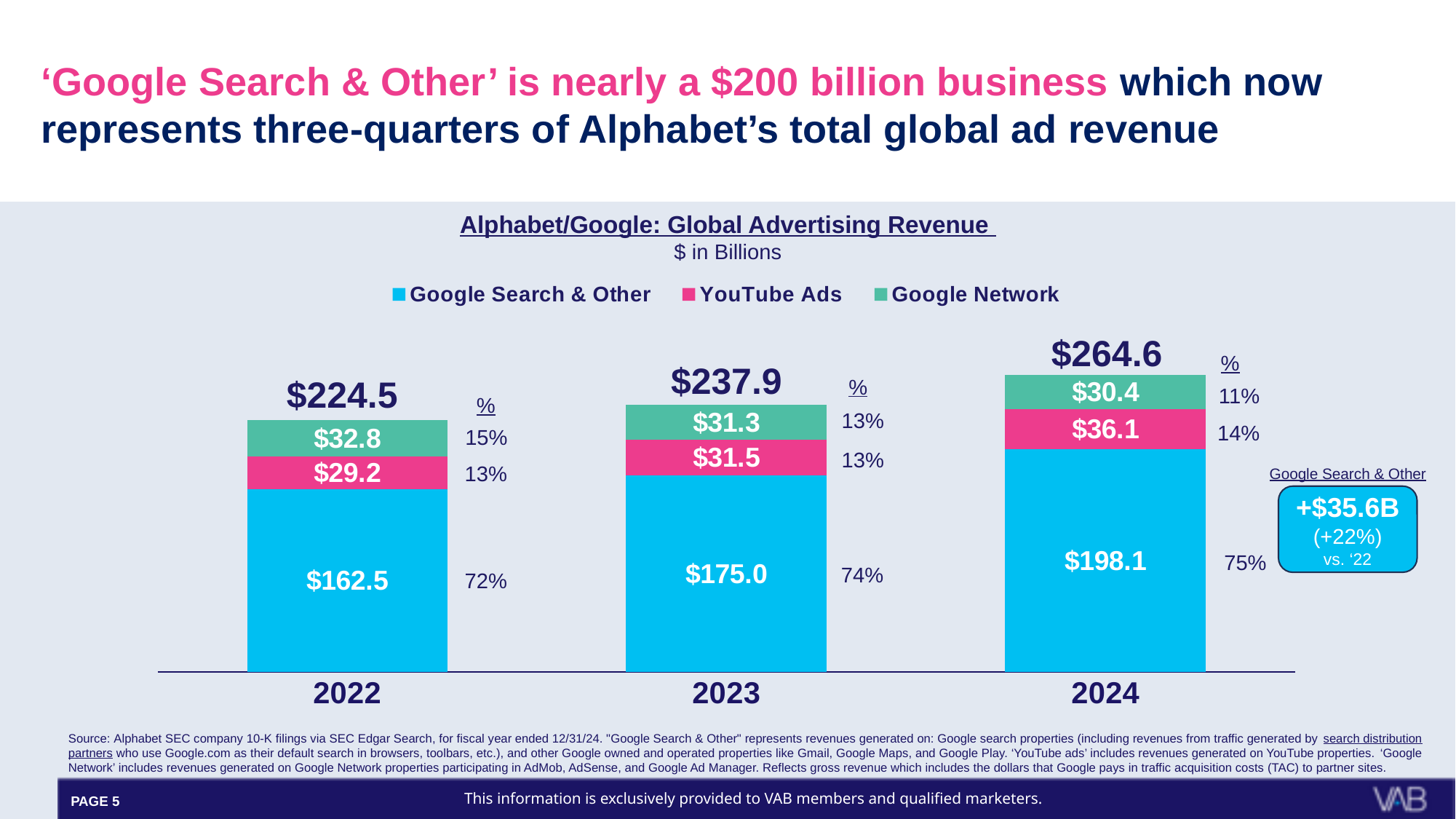
What is the value for YouTube Ads in 2022? $29.2 Which year has the highest total global advertising revenue? 2024 Which year has the lowest value for Google Search & Other? 2022 Does the Google Search & Other value rise or fall from 2022 to 2024? Rise What is the total of the stacked bar for 2023? $237.9 What is the value for Google Search & Other in 2024? $198.1 What is the value for Google Network in 2023? $31.3 Which is larger in 2024: YouTube Ads or Google Network? YouTube Ads How many years are shown on the x axis? 3 How many series does the legend list? 3 What kind of chart is shown on the slide? Stacked bar chart What is the difference between the Google Search & Other values for 2024 and 2023? $23.1